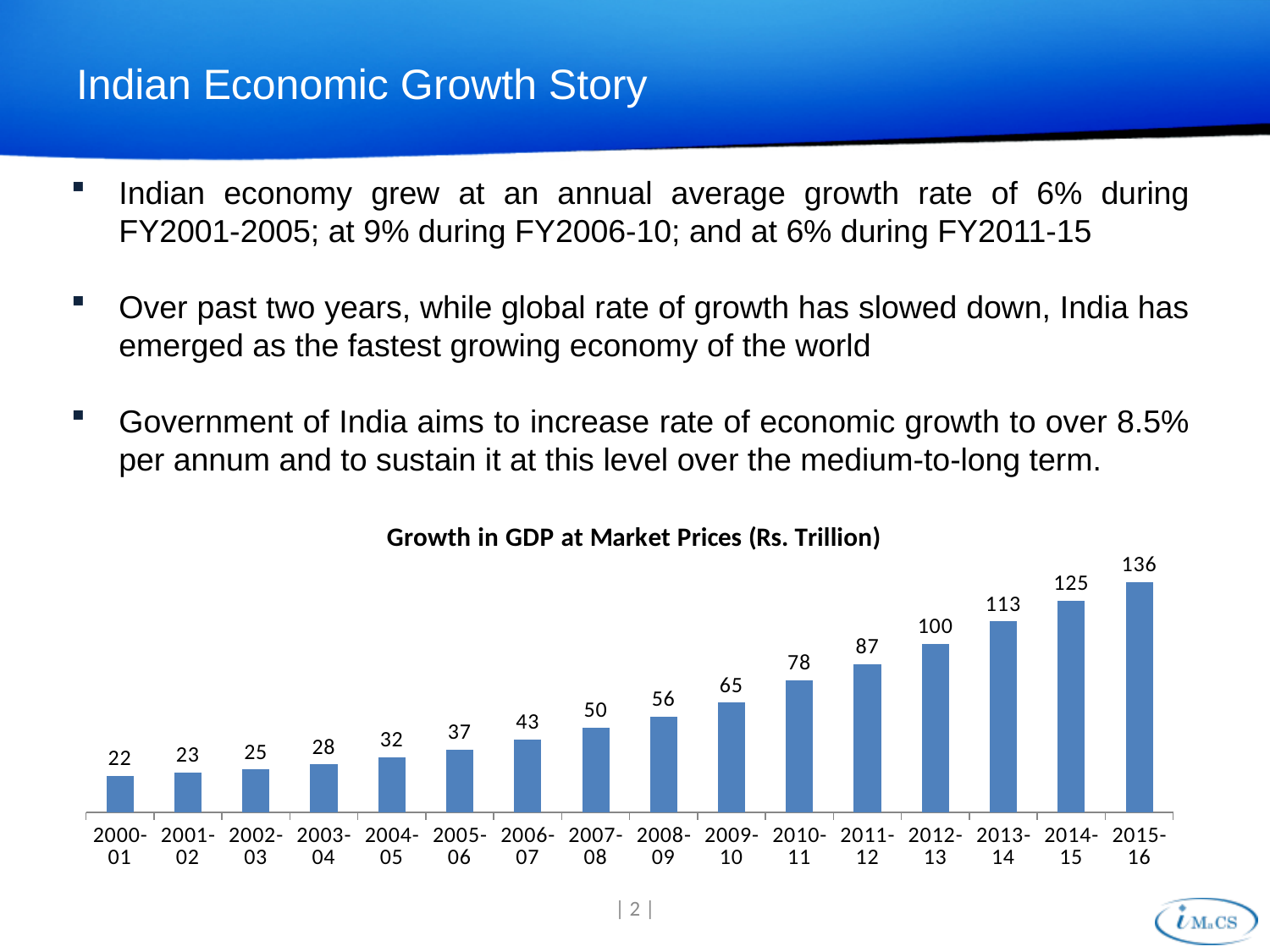
Which year has the lowest GDP value in the chart? 2000-01 What is the GDP value shown for 2012-13? 100 What is the difference between the GDP values for 2015-16 and 2014-15? 11 What is the GDP value shown for 2000-01? 22 What is the title of the chart? Growth in GDP at Market Prices (Rs. Trillion) What kind of chart is shown on the slide? Bar chart How many years are shown on the x axis of the chart? 16 What is the difference between the GDP values for 2009-10 and 2005-06? 28 Which is larger, the GDP value for 2007-08 or for 2008-09? 2008-09 Which year has the highest GDP value in the chart? 2015-16 Do the GDP values rise or fall from 2000-01 to 2015-16? Rise What is the GDP value shown for 2010-11? 78